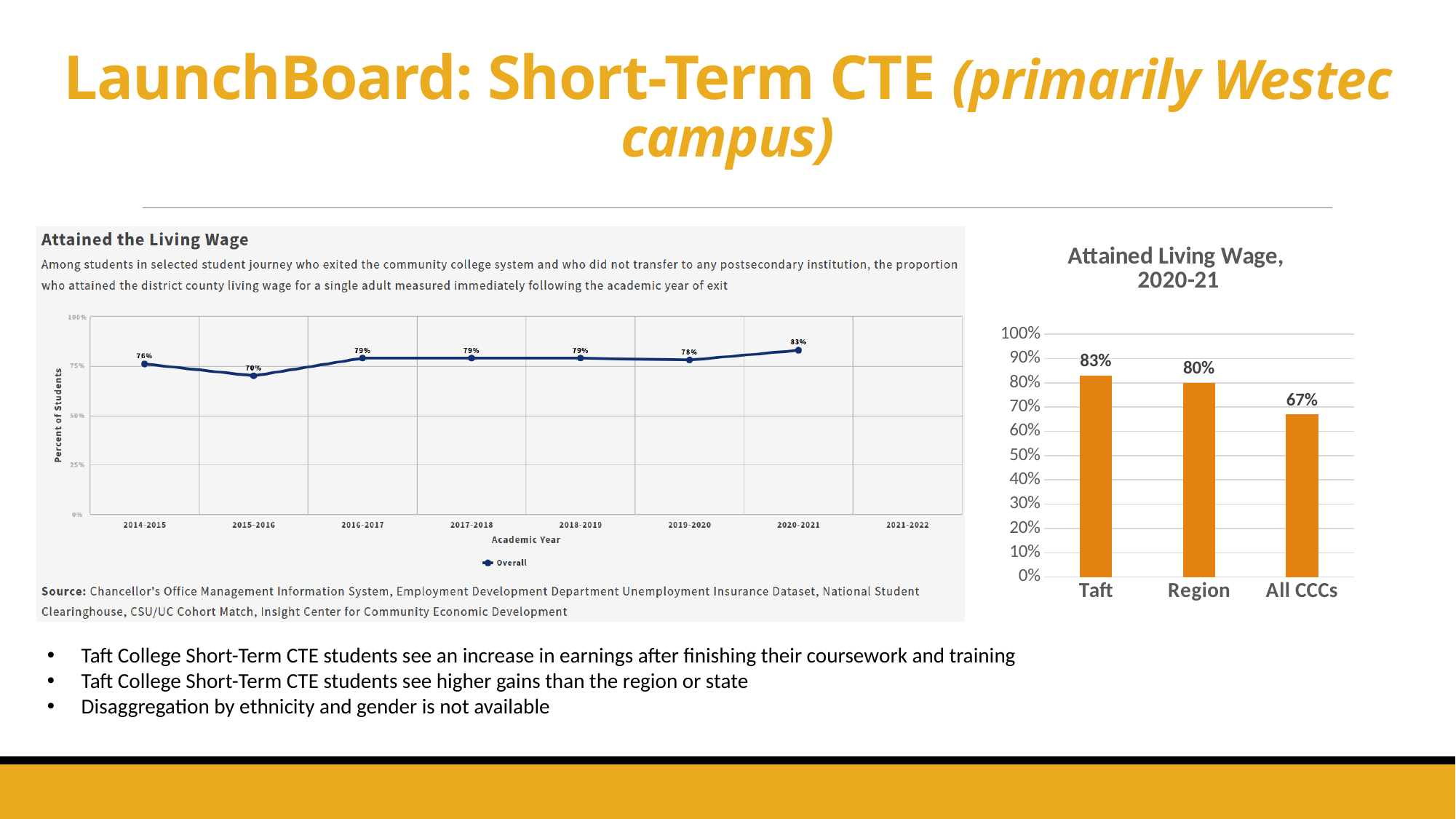
In the 'Attained Living Wage, 2020-21' bar chart, what is the value for All CCCs? 67% In the 'Attained Living Wage, 2020-21' bar chart, which category has the highest value? Taft In the 'Attained the Living Wage' line chart on the left, what is the name of the series shown in the legend? Overall In the 'Attained the Living Wage' line chart on the left, what is the difference between the 2020-2021 value and the 2014-2015 value? 7% In the 'Attained the Living Wage' line chart on the left, what is the value for 2020-2021? 83% In the 'Attained the Living Wage' line chart on the left, what is the value for 2015-2016? 70% In the 'Attained Living Wage, 2020-21' bar chart, what is the difference between the Taft value and the All CCCs value? 16% In the 'Attained Living Wage, 2020-21' bar chart, which category has the lowest value? All CCCs In the 'Attained Living Wage, 2020-21' bar chart, how many categories are shown? 3 What kind of chart is the 'Attained Living Wage, 2020-21' chart on the right? Bar chart In the 'Attained Living Wage, 2020-21' bar chart, what is the value for Taft? 83% In the 'Attained the Living Wage' line chart on the left, which academic year has the lowest value? 2015-2016